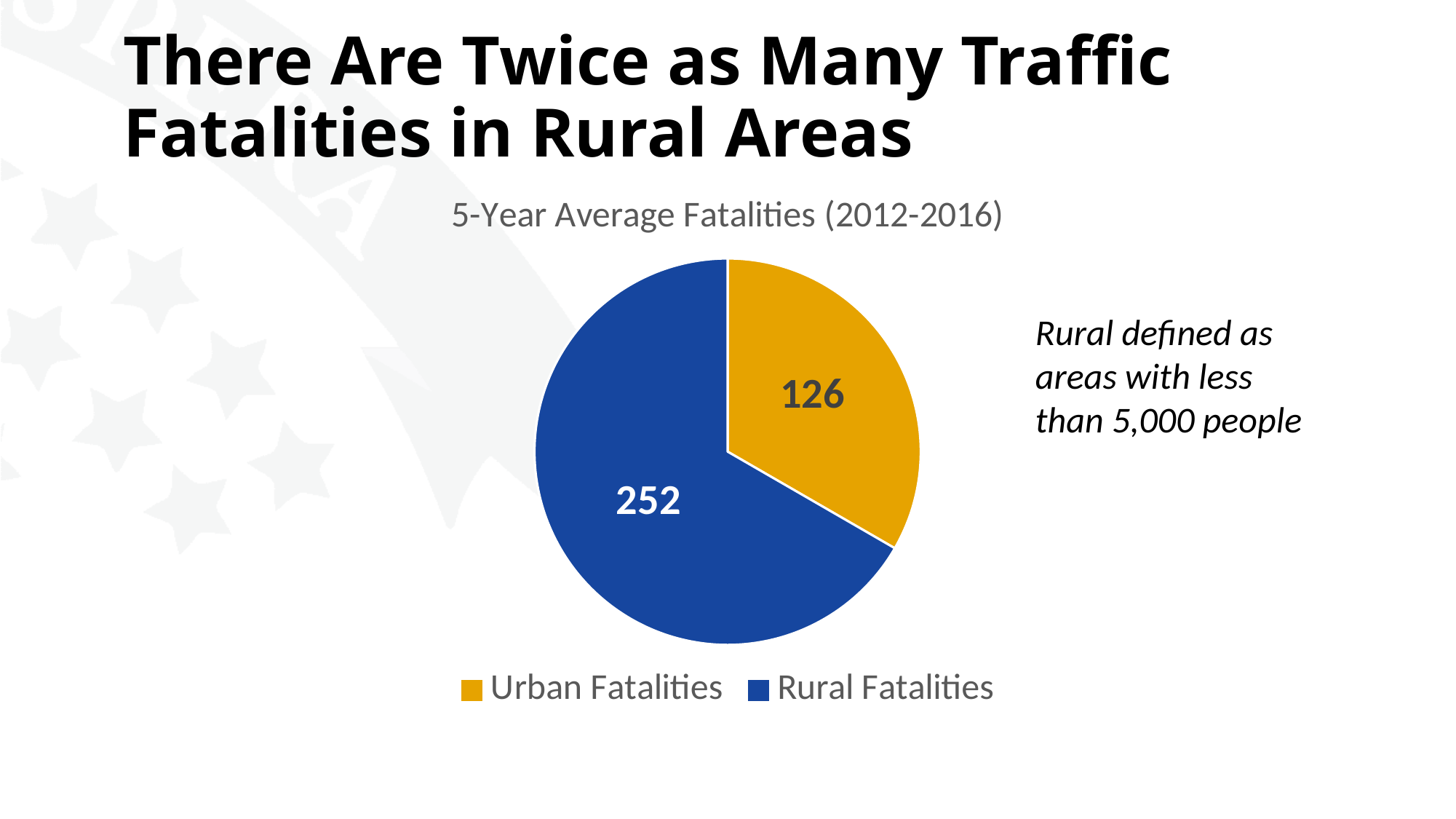
What is the difference between Rural Fatalities and Urban Fatalities? 126 What is the value for Urban Fatalities? 126 How many slices does the pie chart have? 2 What is the total of the two slices in the pie chart? 378 Which category has the smallest slice of the pie? Urban Fatalities What kind of chart is shown on the slide? Pie chart What is the value for Rural Fatalities? 252 Which is larger, Urban Fatalities or Rural Fatalities? Rural Fatalities How many entries does the legend list? 2 What is the title of the chart? 5-Year Average Fatalities (2012-2016) Which category has the largest slice of the pie? Rural Fatalities